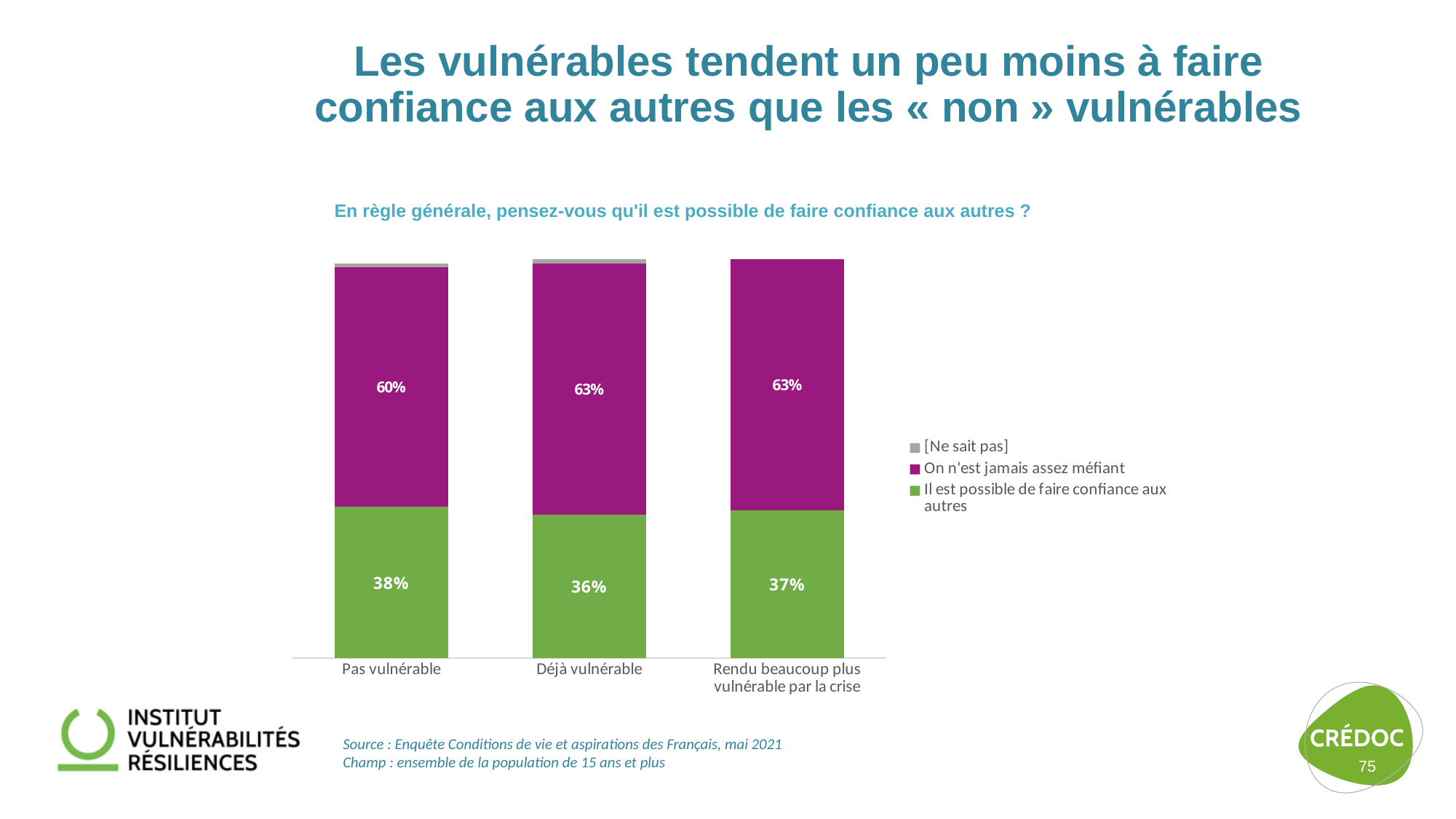
What is the value for 'Il est possible de faire confiance aux autres' in the 'Rendu beaucoup plus vulnérable par la crise' category? 37% How many series does the legend list? 3 Which category has the lowest share for 'Il est possible de faire confiance aux autres'? Déjà vulnérable What kind of chart is shown on the slide? Stacked bar chart What is the difference in percentage points between 'Il est possible de faire confiance aux autres' for 'Pas vulnérable' and for 'Déjà vulnérable'? 2 percentage points What is the value for 'On n'est jamais assez méfiant' in the 'Pas vulnérable' category? 60% What percentage of the 'Pas vulnérable' group says 'Il est possible de faire confiance aux autres'? 38% Which category has the highest share for 'Il est possible de faire confiance aux autres'? Pas vulnérable Which is larger: the 'On n'est jamais assez méfiant' share for 'Pas vulnérable' or for 'Déjà vulnérable'? Déjà vulnérable How many categories are shown on the x axis of the chart? 3 What percentage of the 'Déjà vulnérable' group says 'On n'est jamais assez méfiant'? 63% Which category has the lowest share for 'On n'est jamais assez méfiant'? Pas vulnérable